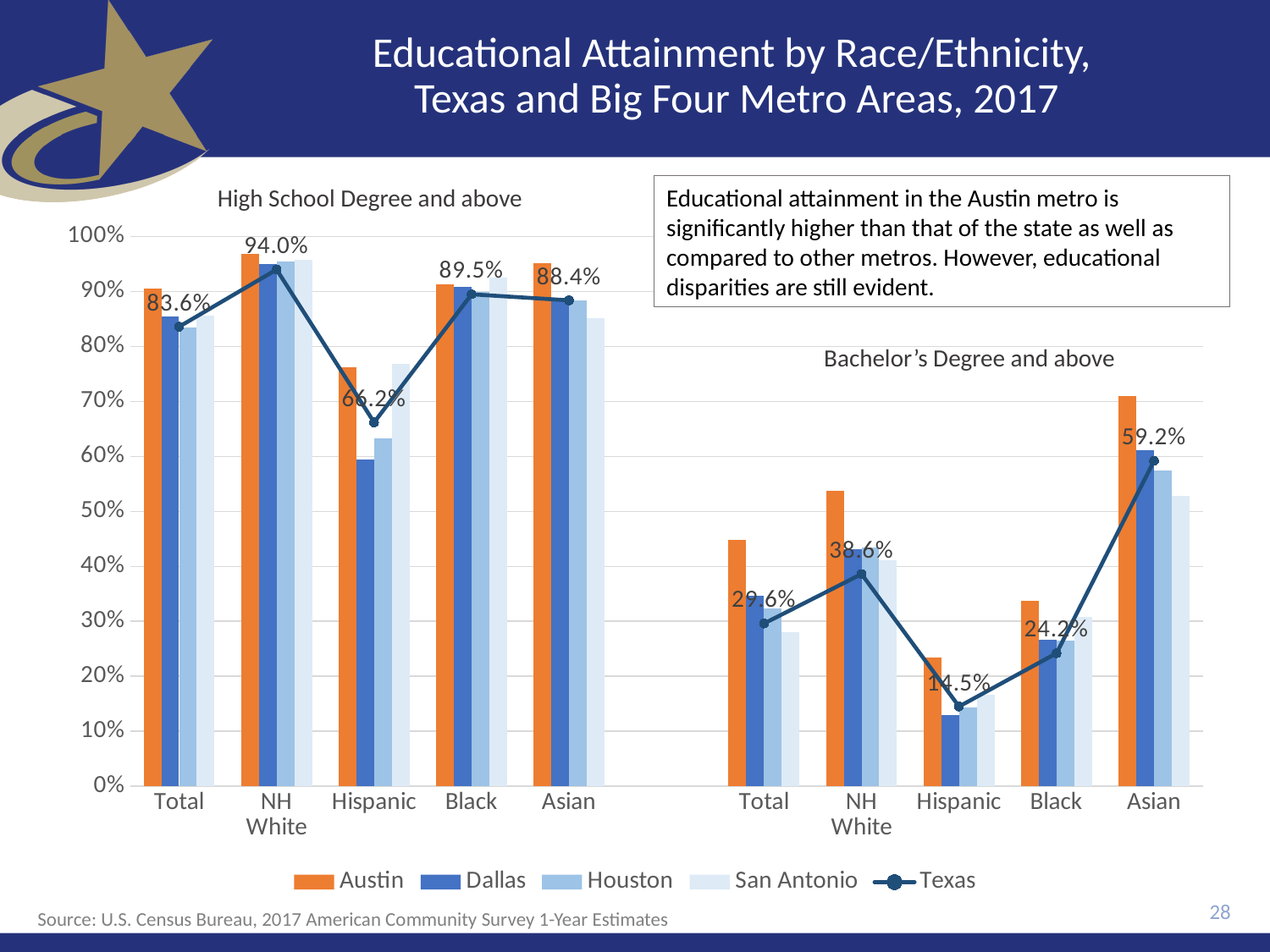
In the High School Degree and above section, which category has the highest Texas value? NH White In the High School Degree and above section, what is the Texas value for Hispanic? 66.2% In the Bachelor's Degree and above section, is the Texas value for Black larger or smaller than the Texas value for NH White? smaller In the Bachelor's Degree and above section, what is the Texas value for Asian? 59.2% In the High School Degree and above section, what is the Texas value for NH White? 94.0% How many series does the legend list? 5 Which series is shown as a line rather than bars? Texas In the Bachelor's Degree and above section, which category has the lowest Texas value? Hispanic In the High School Degree and above section, what is the difference between the Texas values for NH White and Hispanic? 27.8% In the Bachelor's Degree and above section, what is the Texas value for Hispanic? 14.5% In the Bachelor's Degree and above section, what is the difference between the Texas values for Asian and Total? 29.6% In the Bachelor's Degree and above section, is the Austin value for Asian greater or less than 60%? greater